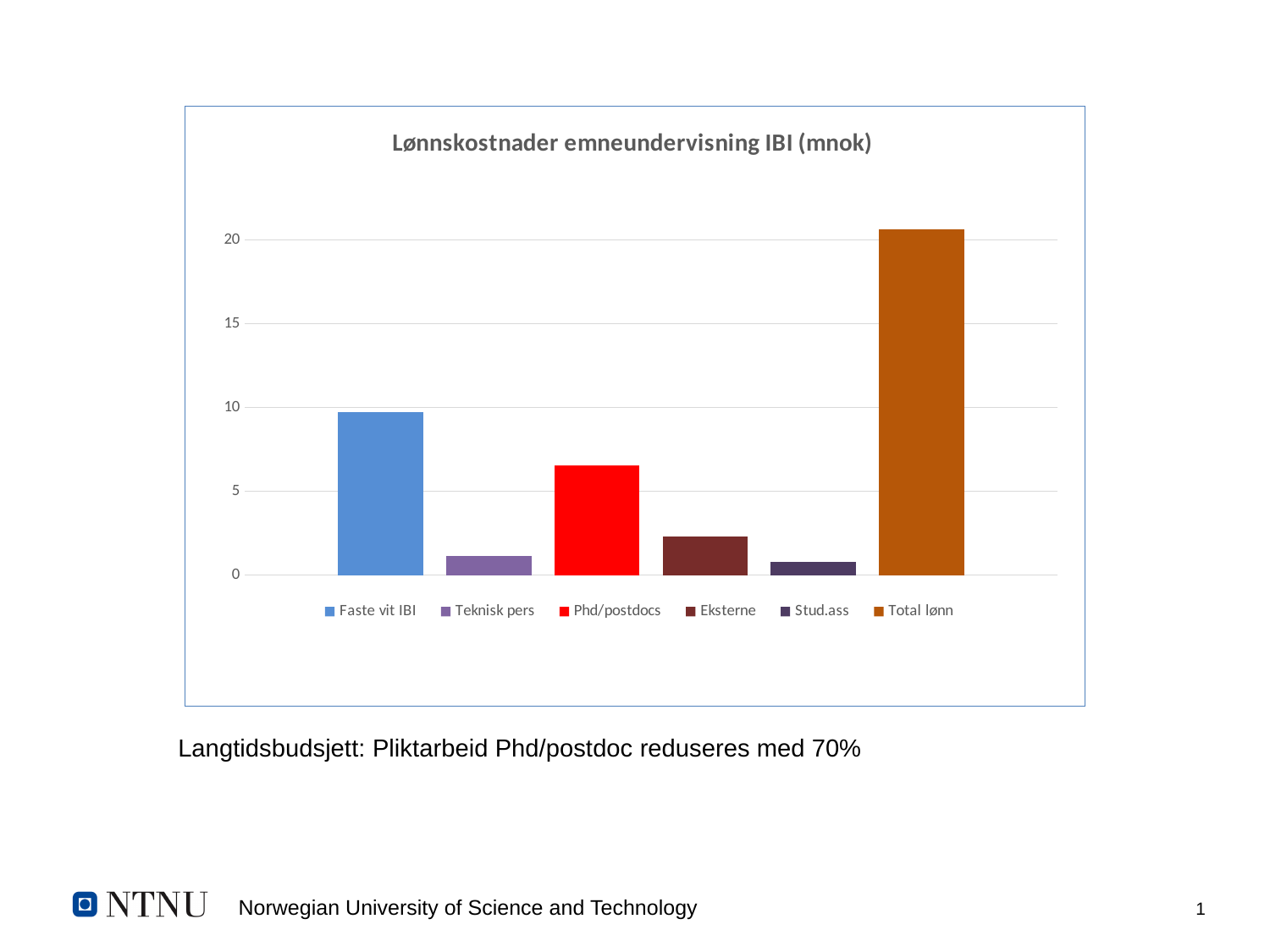
Which is larger, Faste vit IBI or Phd/postdocs? Faste vit IBI How many series does the legend list? 6 How many bars are plotted in the chart? 6 Which series has the lowest bar? Stud.ass Which is larger, Eksterne or Teknisk pers? Eksterne Is the value for Faste vit IBI greater or less than 10? less What is the title of the chart? Lønnskostnader emneundervisning IBI (mnok) Is the value for Phd/postdocs greater or less than 5? greater What kind of chart is shown on the slide? Bar chart Is the value for Total lønn greater or less than 20? greater What colour is the bar for Phd/postdocs? Red Which series has the highest bar? Total lønn